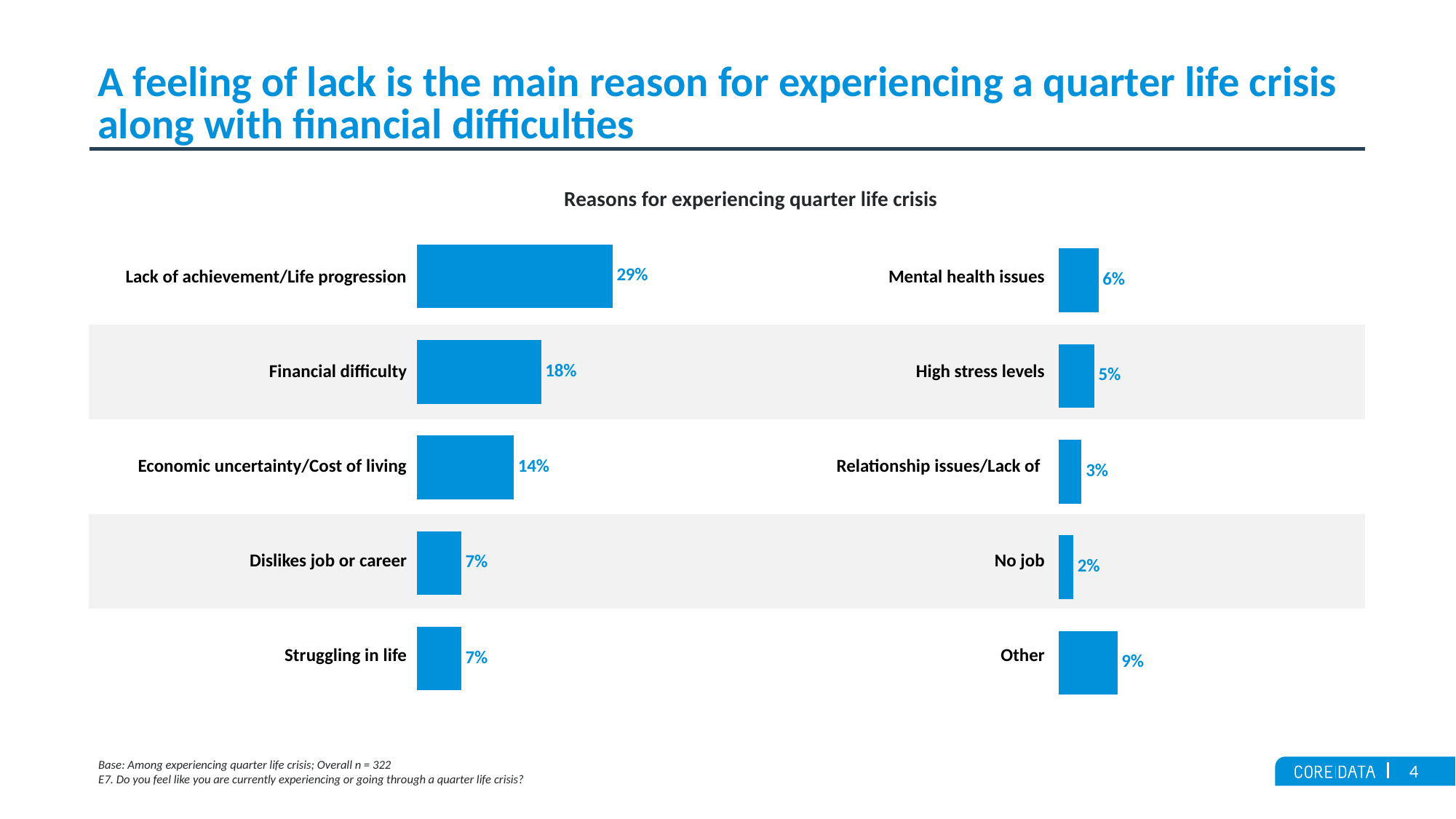
Which reason has the highest percentage? Lack of achievement/Life progression Which is larger, Other or Dislikes job or career? Other What is the difference between Lack of achievement/Life progression and Financial difficulty? 11% What is the difference between Economic uncertainty/Cost of living and High stress levels? 9% What is the value for Financial difficulty? 18% How many reasons are shown in the chart? 10 What is the value for Other? 9% What percentage is shown for Lack of achievement/Life progression? 29% Which reason has the lowest percentage? No job What is the title of the chart? Reasons for experiencing quarter life crisis What type of chart is shown on the slide? Bar chart What percentage is shown for Mental health issues? 6%